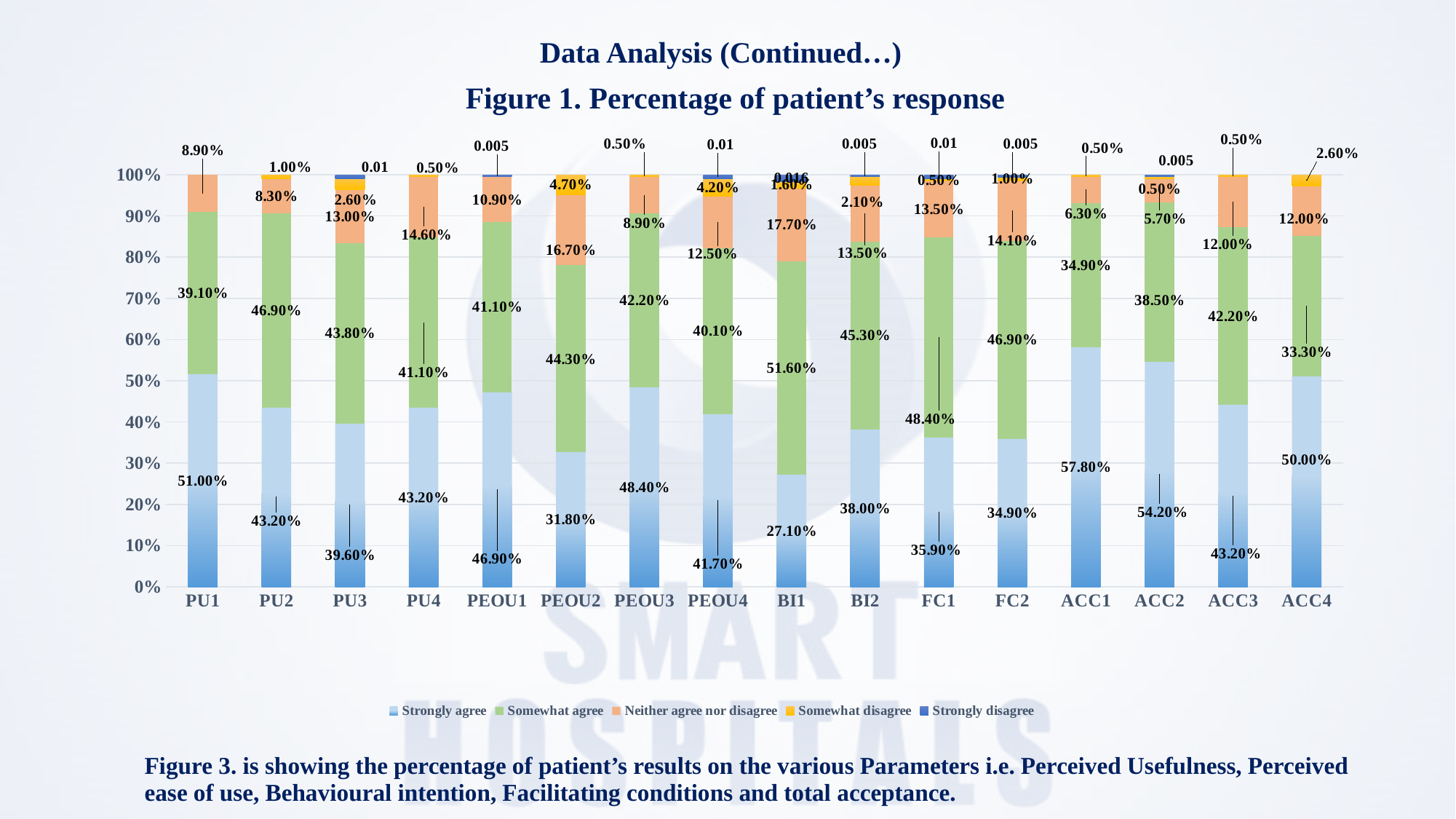
How many series does the legend list? 5 Which category has the highest "Strongly agree" percentage? ACC1 What is the "Somewhat agree" value for BI1? 51.60% What kind of chart is shown on the slide? Stacked bar chart How many categories are shown on the x axis? 16 What is the "Neither agree nor disagree" value for PEOU2? 16.70% What is the difference between the "Strongly agree" values for ACC1 and ACC2? 3.60% What percentage of patients responded "Strongly agree" for PU1? 51.00% What is the "Somewhat disagree" value for ACC4? 2.60% Which category has the lowest "Strongly agree" percentage? BI1 Which is larger, the "Somewhat agree" value for PU2 or for PU3? PU2 What is the title of the chart? Figure 1. Percentage of patient's response